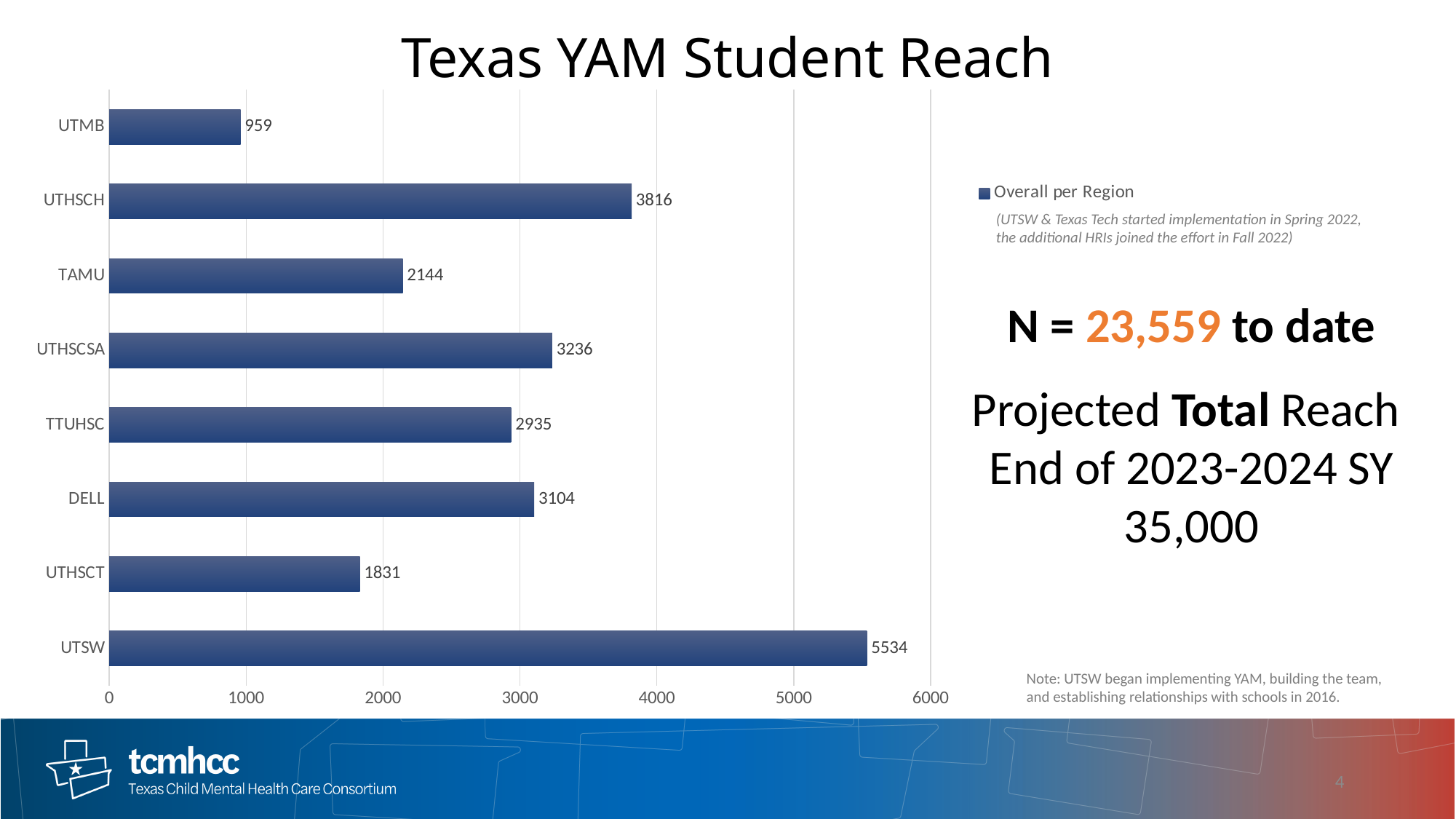
Which region has the lowest value? UTMB What kind of chart is shown on the slide? bar chart What is the difference between the values for DELL and TTUHSC? 169 What is the value for UTSW? 5534 What is the legend entry for the series in the chart? Overall per Region What is the value for TAMU? 2144 What is the difference between the values for UTSW and UTHSCH? 1718 Which is larger, the value for UTHSCSA or the value for DELL? UTHSCSA Which region has the highest value? UTSW How many regions are shown in the chart? 8 Is the value for UTHSCT greater or less than 2000? less What is the value for UTHSCH? 3816